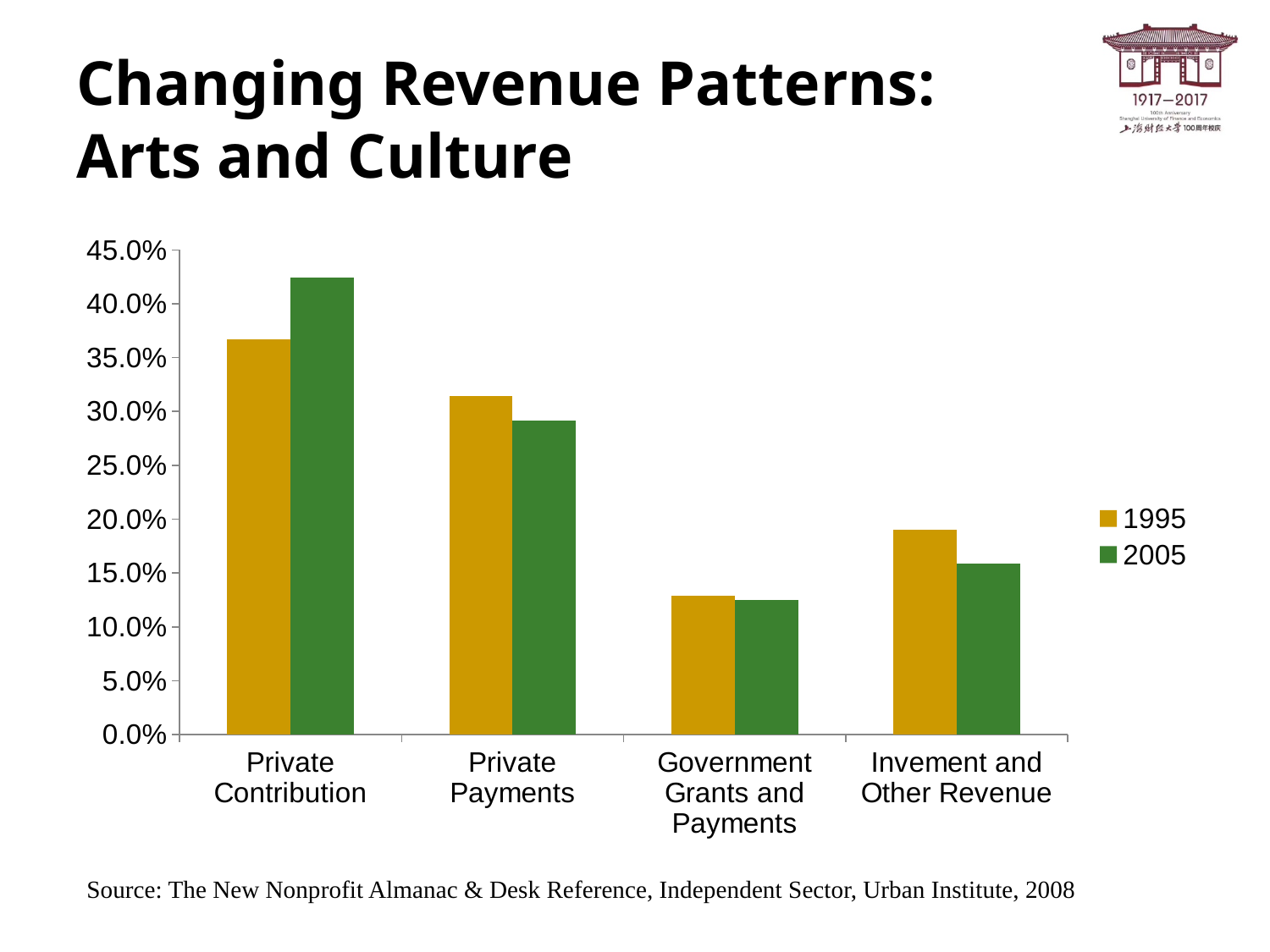
How many categories are shown on the x axis of the chart? 4 Which category has the highest value for the 2005 series? Private Contribution For Invement and Other Revenue, which series has the larger value, 1995 or 2005? 1995 Which category has the lowest value for the 1995 series? Government Grants and Payments Is the 2005 value for Private Contribution greater or less than 40.0%? greater Which category has the highest value for the 1995 series? Private Contribution Which category has the lowest value for the 2005 series? Government Grants and Payments Is the 1995 value for Private Payments greater or less than 30.0%? greater Which two years are listed in the chart's legend? 1995 and 2005 How many series does the chart's legend list? 2 What kind of chart is shown on the slide? bar chart For Private Contribution, which series has the larger value, 1995 or 2005? 2005